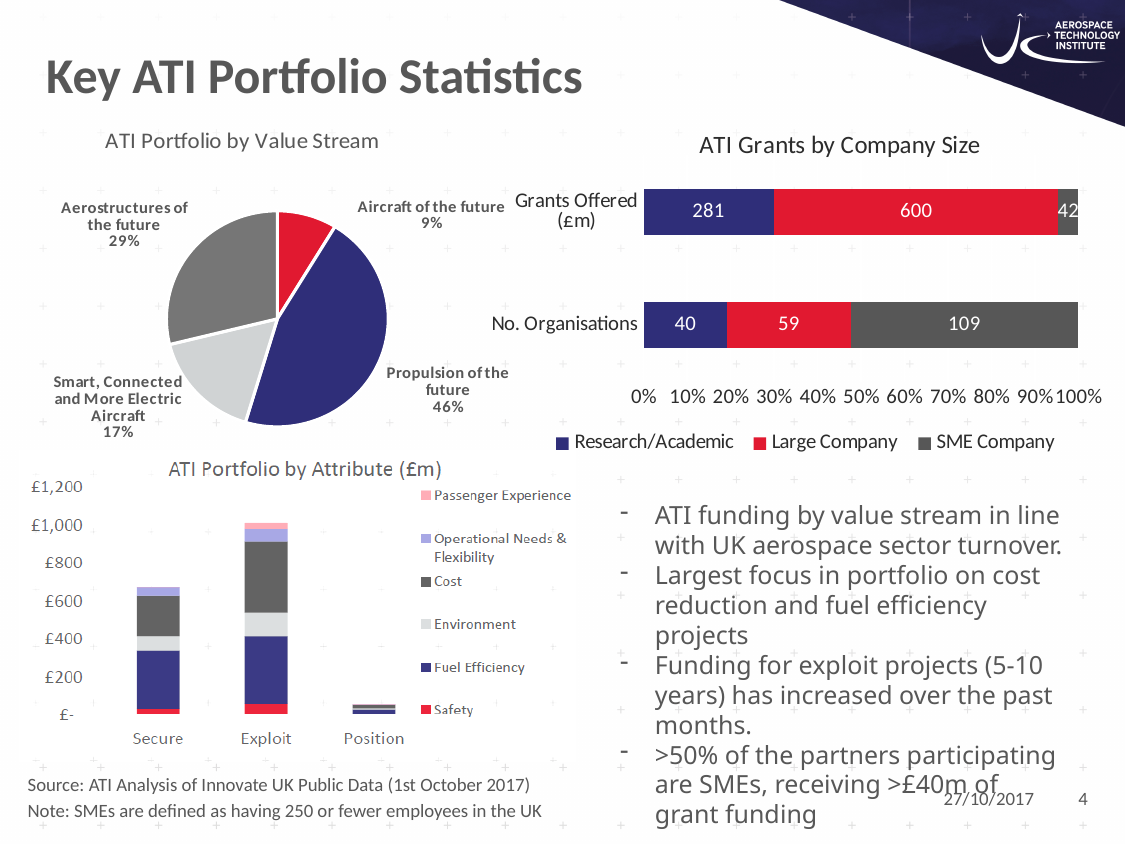
In the ATI Portfolio by Value Stream pie chart, what share does Propulsion of the future have? 46% In the ATI Grants by Company Size chart, how many series does the legend list? 3 In the ATI Portfolio by Attribute (£m) chart, is the total for Exploit greater or less than £800? greater In the ATI Portfolio by Value Stream pie chart, which value stream has the smallest share? Aircraft of the future In the ATI Portfolio by Attribute (£m) chart, which category has the lowest total? Position How many slices does the ATI Portfolio by Value Stream pie chart have? 4 In the ATI Grants by Company Size chart, what is the Grants Offered (£m) value for Large Company? 600 What type of chart is ATI Portfolio by Attribute (£m)? Stacked bar chart In the ATI Grants by Company Size chart, what is the total Grants Offered (£m) across all three company types? 923 In the ATI Grants by Company Size chart, which company type has the most organisations? SME Company In the ATI Portfolio by Value Stream pie chart, what is the difference in percentage points between Aerostructures of the future and Smart, Connected and More Electric Aircraft? 12 percentage points In the ATI Grants by Company Size chart, what is the No. Organisations value for SME Company? 109